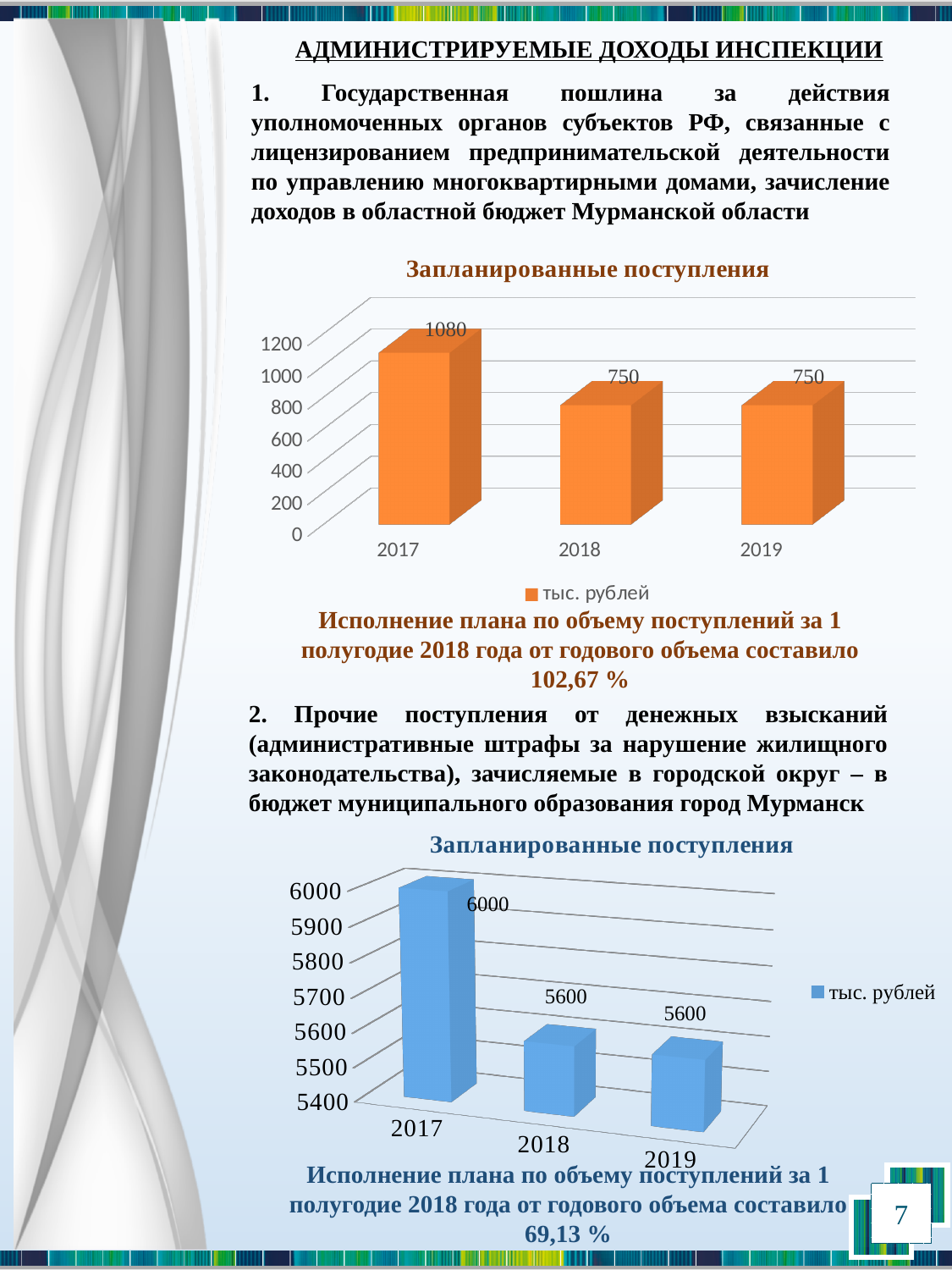
In the top chart (orange bars), which year has the highest value? 2017 In the top chart (orange bars), what is the value for 2018? 750 In the top chart (orange bars), how many years are shown on the x axis? 3 In the bottom chart (blue bars), what is the value for 2017? 6000 In the bottom chart (blue bars), is the value for 2017 larger or smaller than the value for 2018? larger In the bottom chart (blue bars), which year has the highest value? 2017 In the bottom chart (blue bars), what is the difference between the values for 2017 and 2018? 400 In the top chart (orange bars), what series name does the legend show? тыс. рублей In the bottom chart (blue bars), what is the value for 2019? 5600 In the top chart (orange bars), what is the difference between the values for 2017 and 2019? 330 What type of chart is the bottom chart (blue bars)? bar chart In the top chart (orange bars), what is the value for 2017? 1080